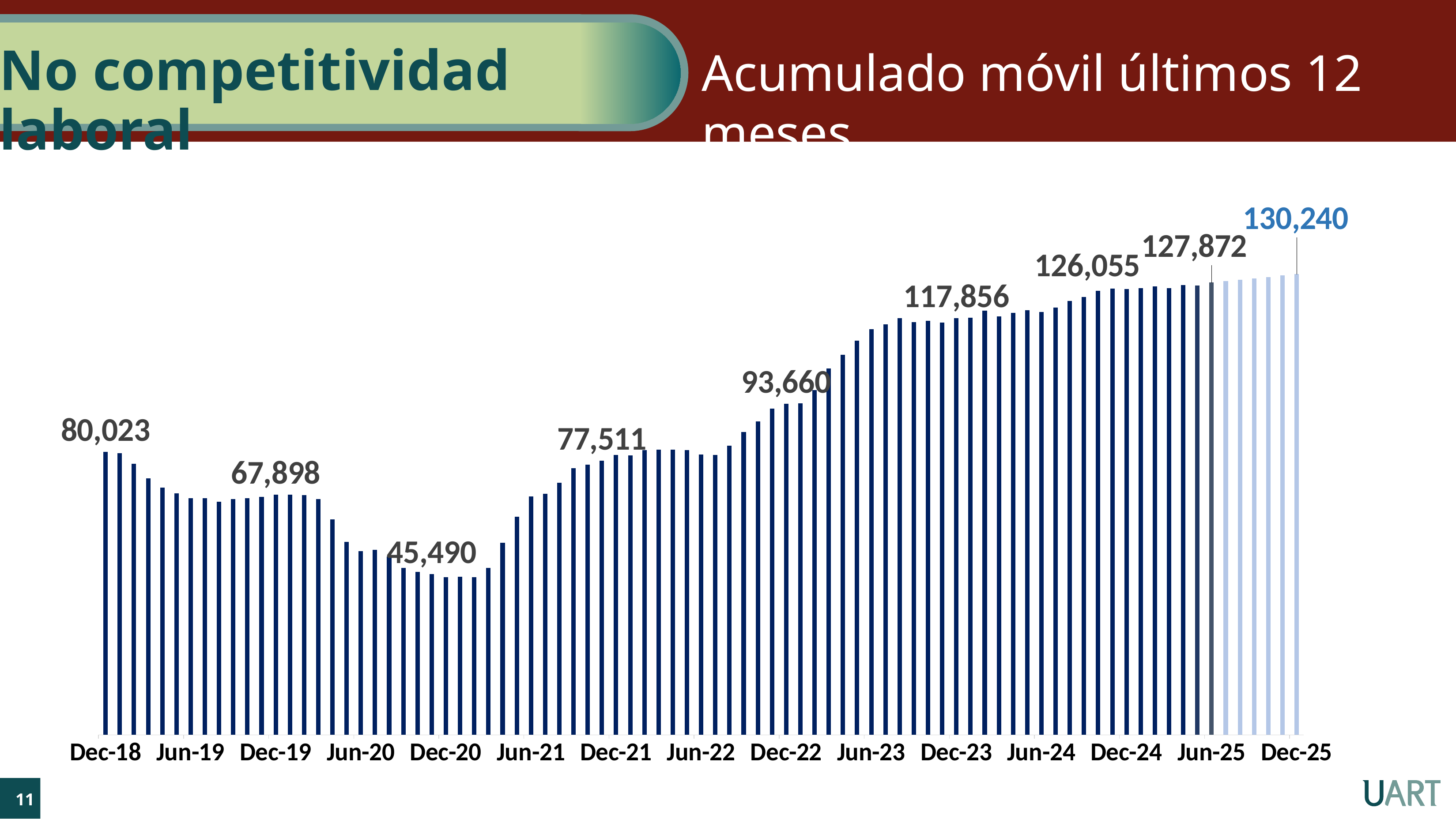
What is the labeled value for Jun-25? 127,872 Which of the labeled values on the chart is the highest? 130,240 What is the labeled value for Dec-22? 93,660 What is the labeled value for Dec-18? 80,023 What is the difference between the labeled values for Dec-25 and Dec-18? 50,217 What kind of chart is shown on the slide? Bar chart Which of the labeled values on the chart is the lowest? 45,490 What is the labeled value for Dec-25? 130,240 Do the values generally rise or fall from Dec-20 to Dec-25? Rise What is the labeled value for Dec-20? 45,490 What is the difference between the labeled values for Dec-23 and Dec-22? 24,196 Which is larger, the labeled value for Dec-19 or for Dec-21? Dec-21